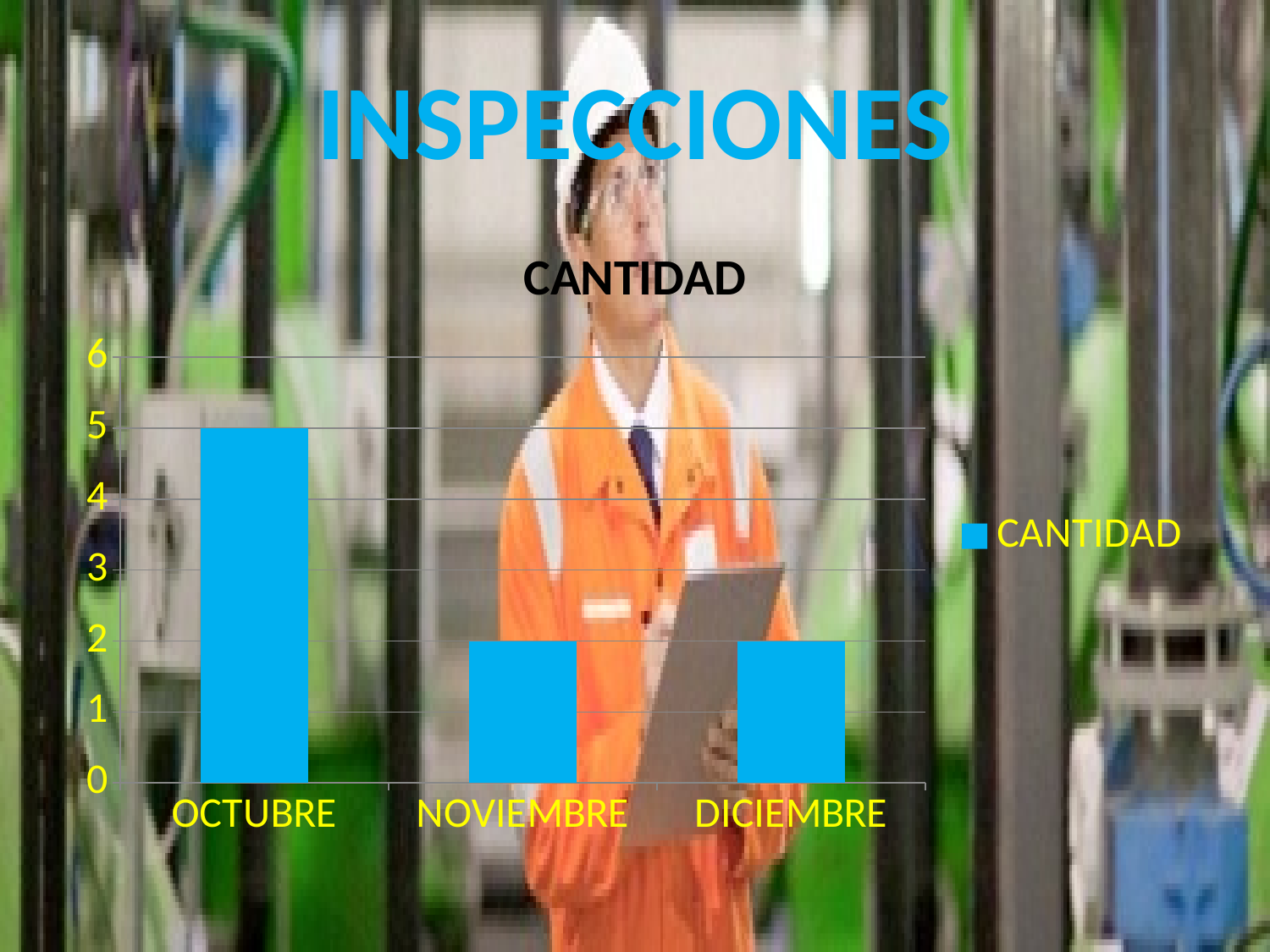
Is the value for OCTUBRE greater or less than 4? greater What is the title of the chart? CANTIDAD What is the value for DICIEMBRE in the CANTIDAD chart? 2 What is the value for OCTUBRE in the CANTIDAD chart? 5 Which month has the highest value in the CANTIDAD chart? OCTUBRE What is the difference between the values for OCTUBRE and NOVIEMBRE? 3 Is the value for NOVIEMBRE greater or less than 3? less How many months are shown on the x axis of the chart? 3 Which is larger, the value for OCTUBRE or the value for DICIEMBRE? OCTUBRE What is the value for NOVIEMBRE in the CANTIDAD chart? 2 What kind of chart is shown on the slide? bar chart How many series does the legend list? 1